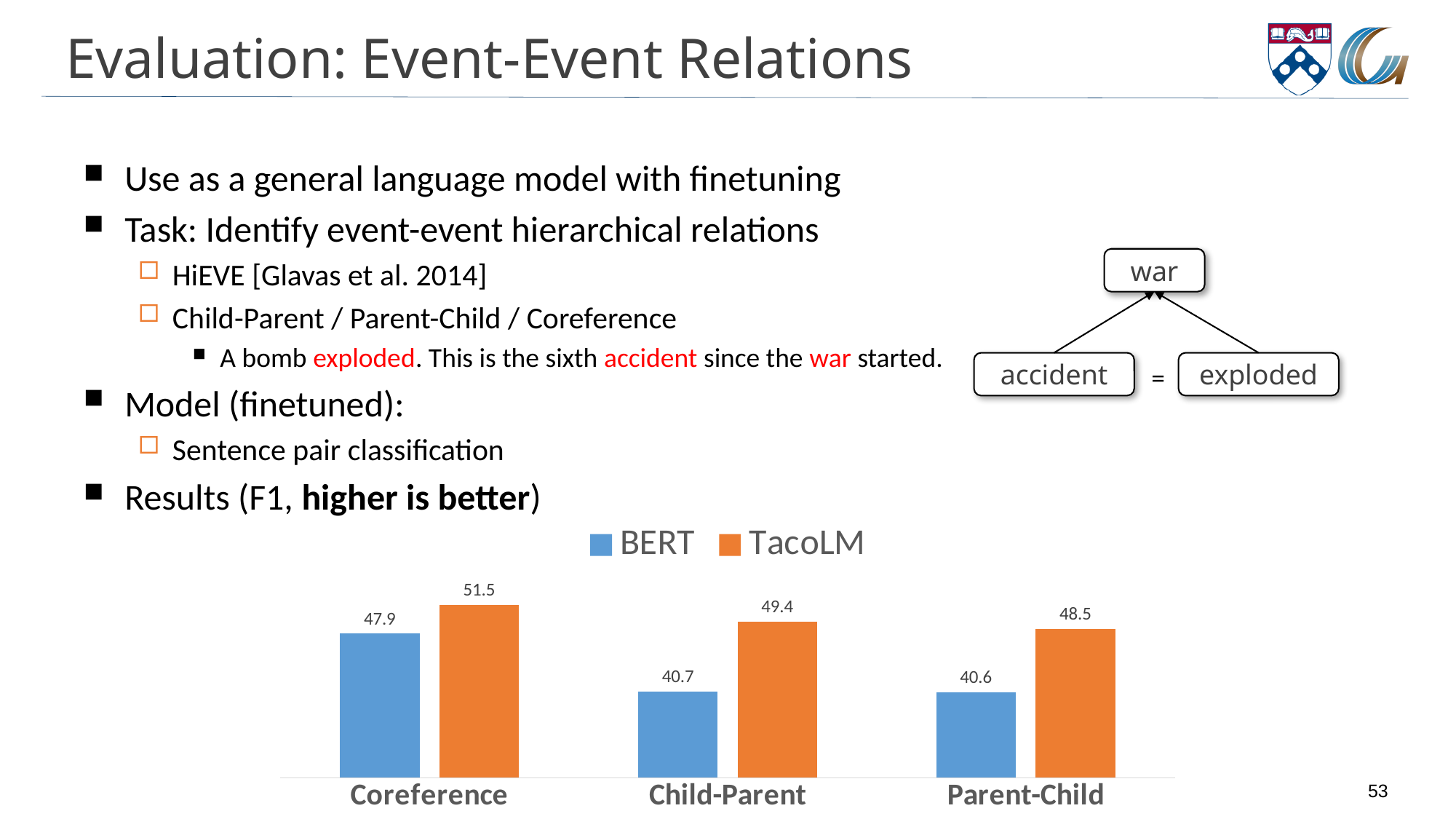
On which relation type does TacoLM achieve its highest F1? Coreference How many series does the chart legend list? 2 What is the F1 value for BERT on Child-Parent? 40.7 What is the F1 value for TacoLM on Parent-Child? 48.5 Which model has the higher F1 on Parent-Child, BERT or TacoLM? TacoLM What is the difference between TacoLM and BERT on Coreference? 3.6 What is the F1 value for TacoLM on Coreference? 51.5 How many relation types are shown on the x axis of the chart? 3 On which relation type does BERT achieve its lowest F1? Parent-Child What is the difference between TacoLM and BERT on Child-Parent? 8.7 What is the F1 value for BERT on Coreference? 47.9 What kind of chart is shown on the slide? Bar chart